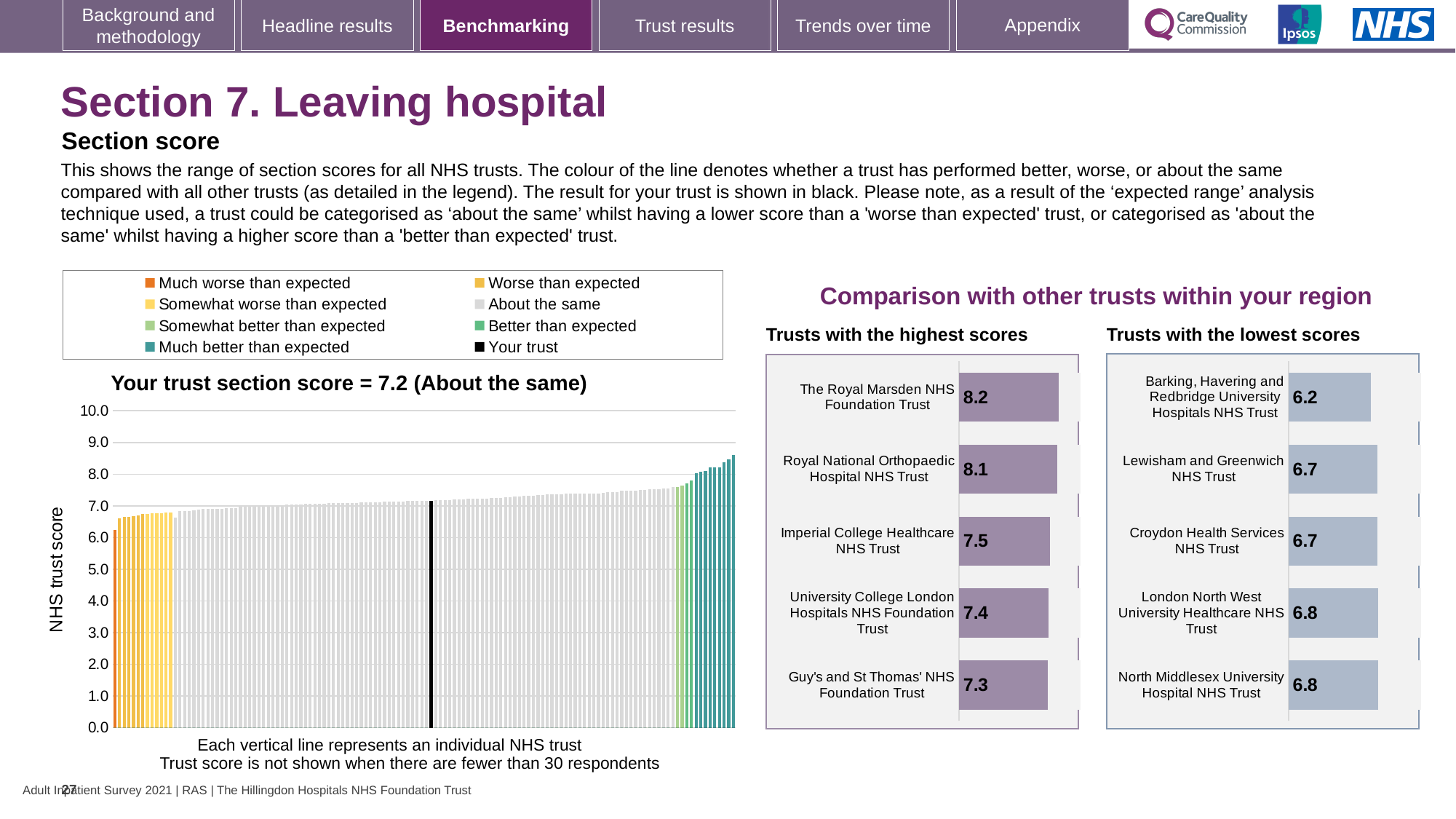
On the 'Trusts with the highest scores' chart, what is the score for The Royal Marsden NHS Foundation Trust? 8.2 On the 'Trusts with the lowest scores' chart, what is the difference between the scores of North Middlesex University Hospital NHS Trust and Barking, Havering and Redbridge University Hospitals NHS Trust? 0.6 On the 'Your trust section score' chart, what category does the black line represent according to the legend? Your trust On the 'Trusts with the highest scores' chart, what is the difference between the scores of The Royal Marsden NHS Foundation Trust and Guy's and St Thomas' NHS Foundation Trust? 0.9 On the 'Your trust section score' chart, what is the section score for your trust? 7.2 On the 'Your trust section score' chart, is the value of the highest bar greater or less than 8.0? greater On the 'Trusts with the lowest scores' chart, which trust has the lowest score? Barking, Havering and Redbridge University Hospitals NHS Trust On the 'Trusts with the highest scores' chart, which trust has the lowest score? Guy's and St Thomas' NHS Foundation Trust On the 'Your trust section score' chart, how many entries does the legend list? 8 On the 'Your trust section score' chart, do the trust scores rise or fall from left to right along the x axis? rise On the 'Trusts with the highest scores' chart, how many trusts are shown? 5 On the 'Your trust section score' chart, what kind of chart is shown? bar chart